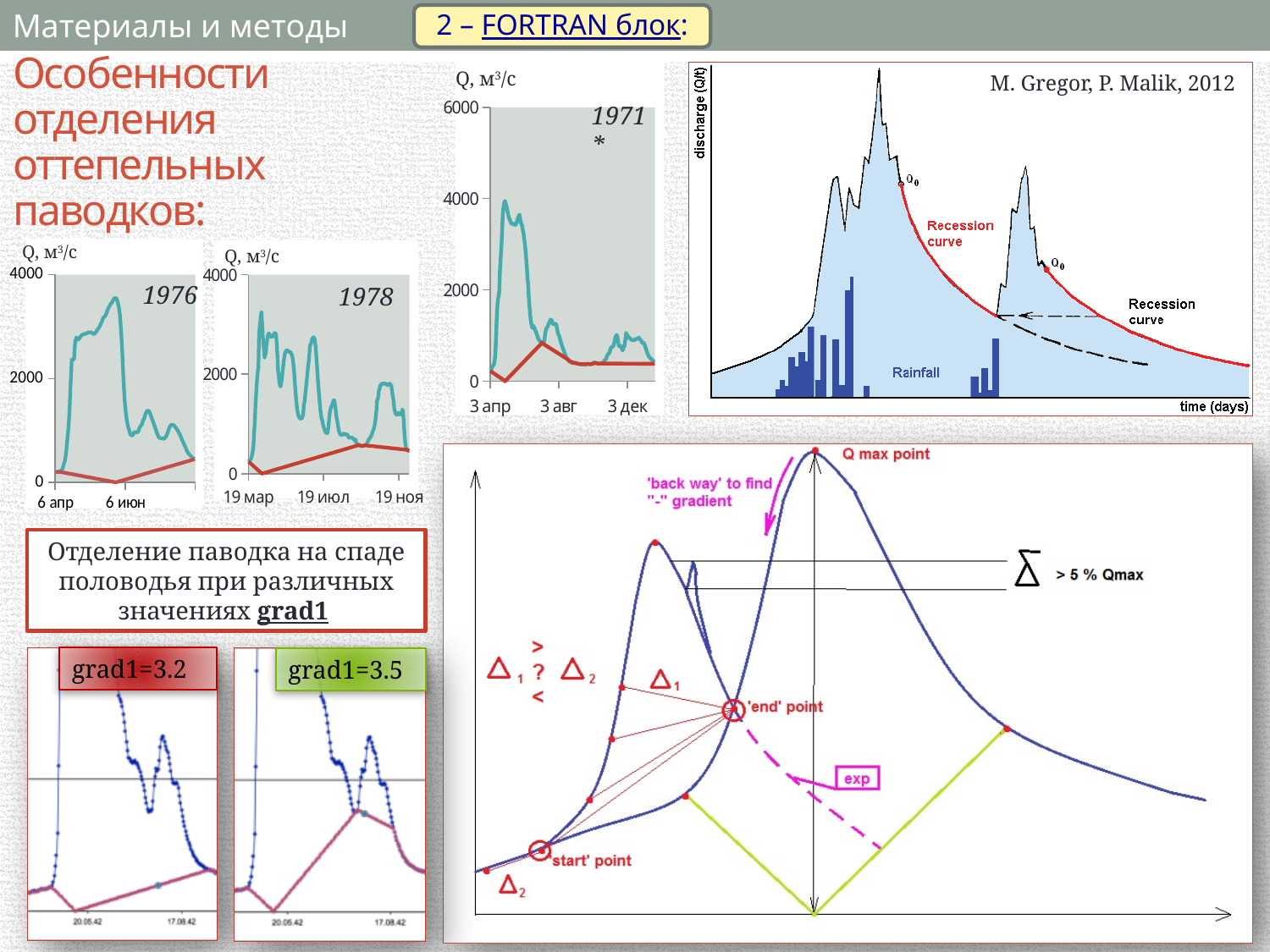
On the 1978 chart, is the peak discharge value greater or less than 2000? greater What kind of chart is the 1976 hydrograph on the left of the slide? line chart Which grad1 value is larger between the two small charts at the bottom left, 3.2 or 3.5? 3.5 On the 1971 chart, is the peak discharge value greater or less than 6000? less What is the last x-axis tick label on the 1971 chart? 3 дек How many yearly hydrographs (labelled with a year) are shown on the slide? 3 What is the first x-axis tick label on the 1978 chart? 19 мар What is the y-axis label on the 1976, 1978 and 1971 hydrographs? Q, м³/с On the 1976 chart, is the peak discharge value greater or less than 2000? greater What is the highest tick value on the y axis of the 1971 chart? 6000 On the chart in the top right (M. Gregor, P. Malik, 2012), what is the x-axis label? time (days)